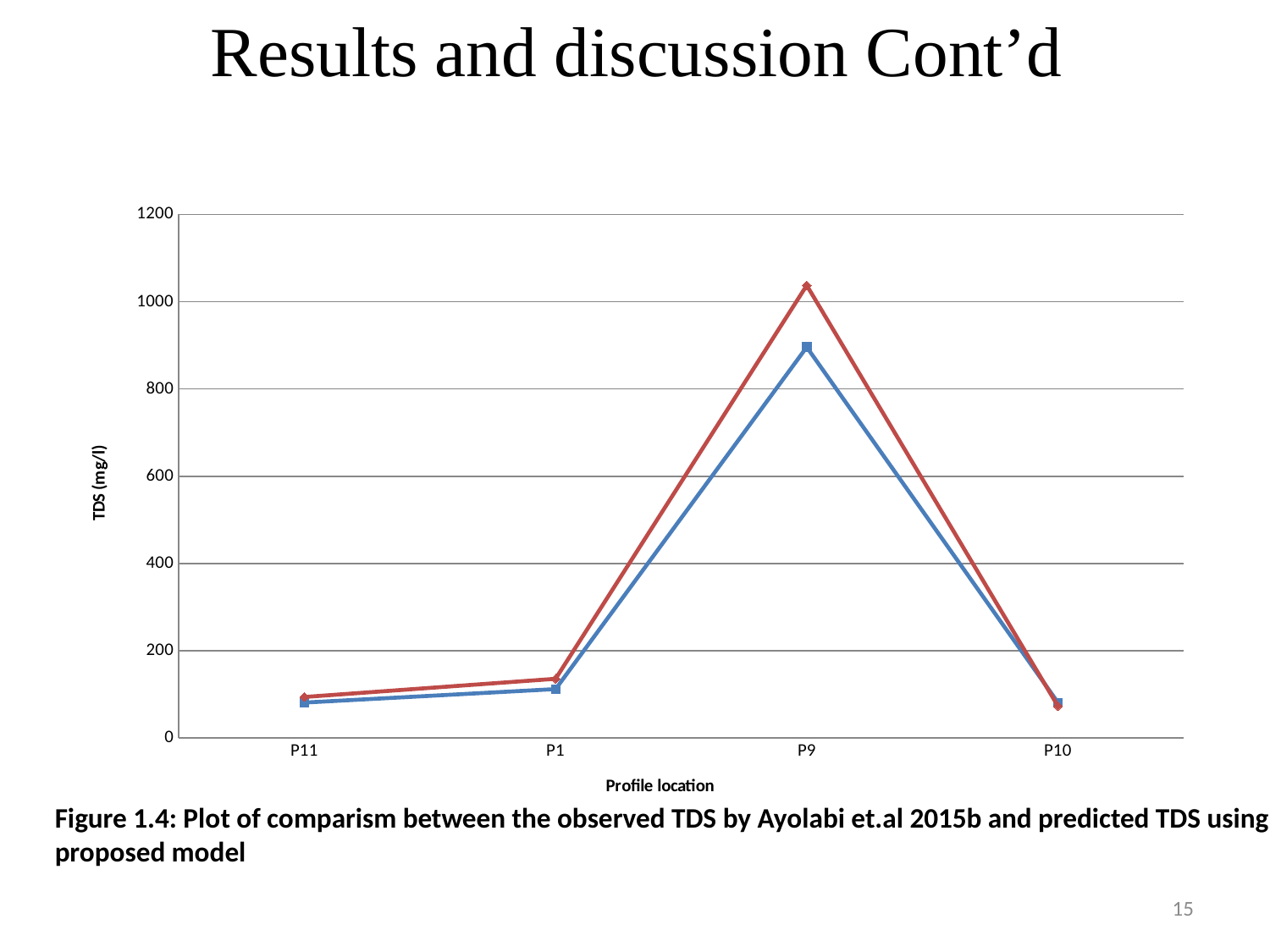
How many profile locations are plotted along the x axis? 4 What kind of chart is shown on the slide? line chart Is the value of the blue line at P11 greater or less than 200? less Do the values rise or fall from P9 to P10? fall At which profile location does the red line reach its highest value? P9 Is the value of the blue line at P9 greater or less than 1000? less At P9, which line has the higher value, the red line or the blue line? red line At which profile location does the blue line reach its highest value? P9 How many lines (series) are plotted on the chart? 2 What is the title of the y axis? TDS (mg/l) Is the value of the red line at P9 greater or less than 1000? greater At which profile location is the red line at its lowest value? P10